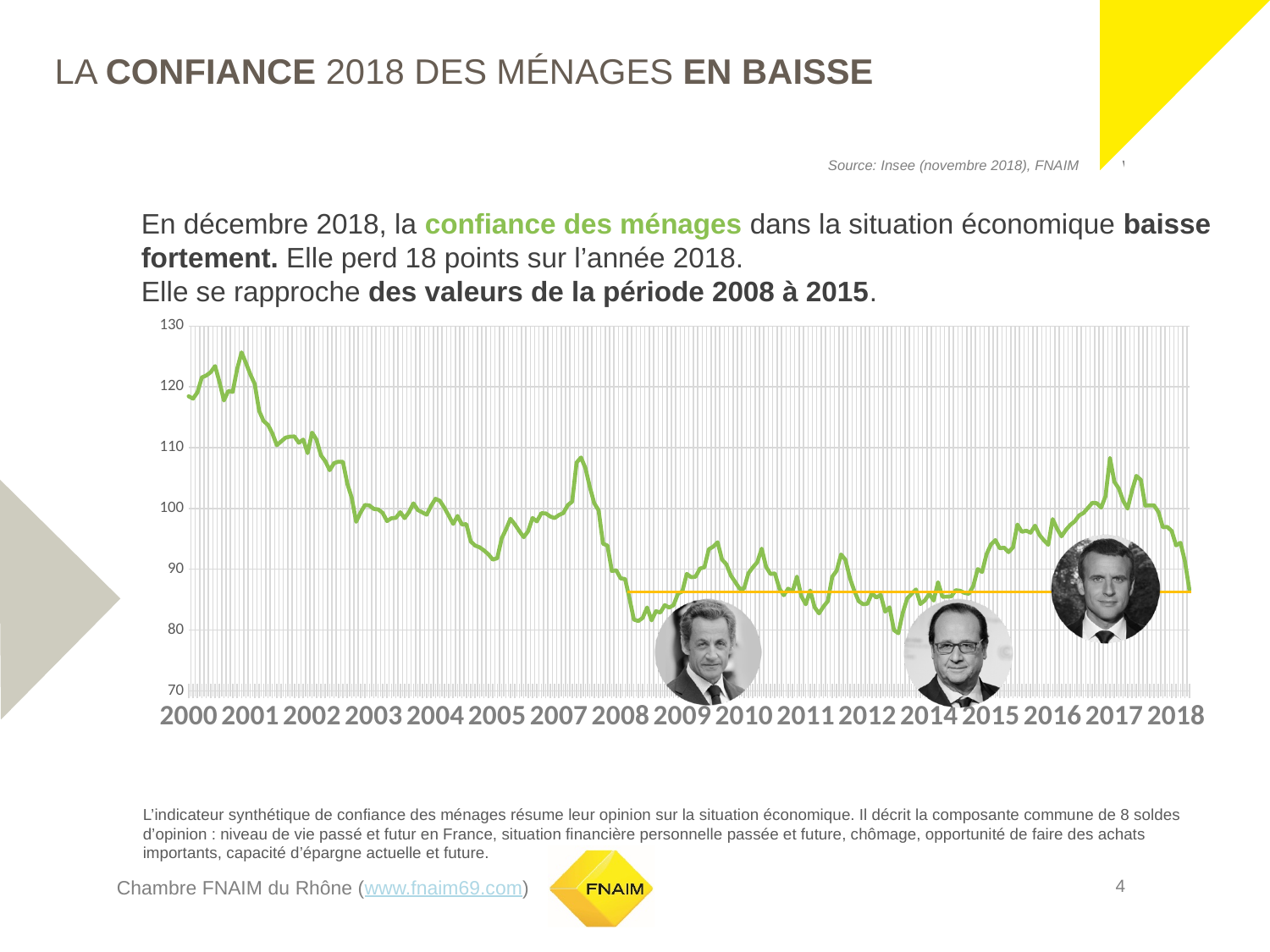
What is the lowest value shown on the vertical axis of the chart? 70 Does the confidence index rise or fall between 2017 and the end of 2018? fall Is the value of the confidence index at the start of 2005 greater or less than 110? less Is the peak value of the confidence index in 2001 greater or less than 120? greater Does the confidence index rise or fall between 2014 and 2017? rise Is the peak value of the confidence index in 2017 greater or less than 100? greater What is the highest value shown on the vertical axis of the chart? 130 What kind of chart is shown on the slide? line chart Is the confidence index higher at the start of 2000 or at the end of 2018? start of 2000